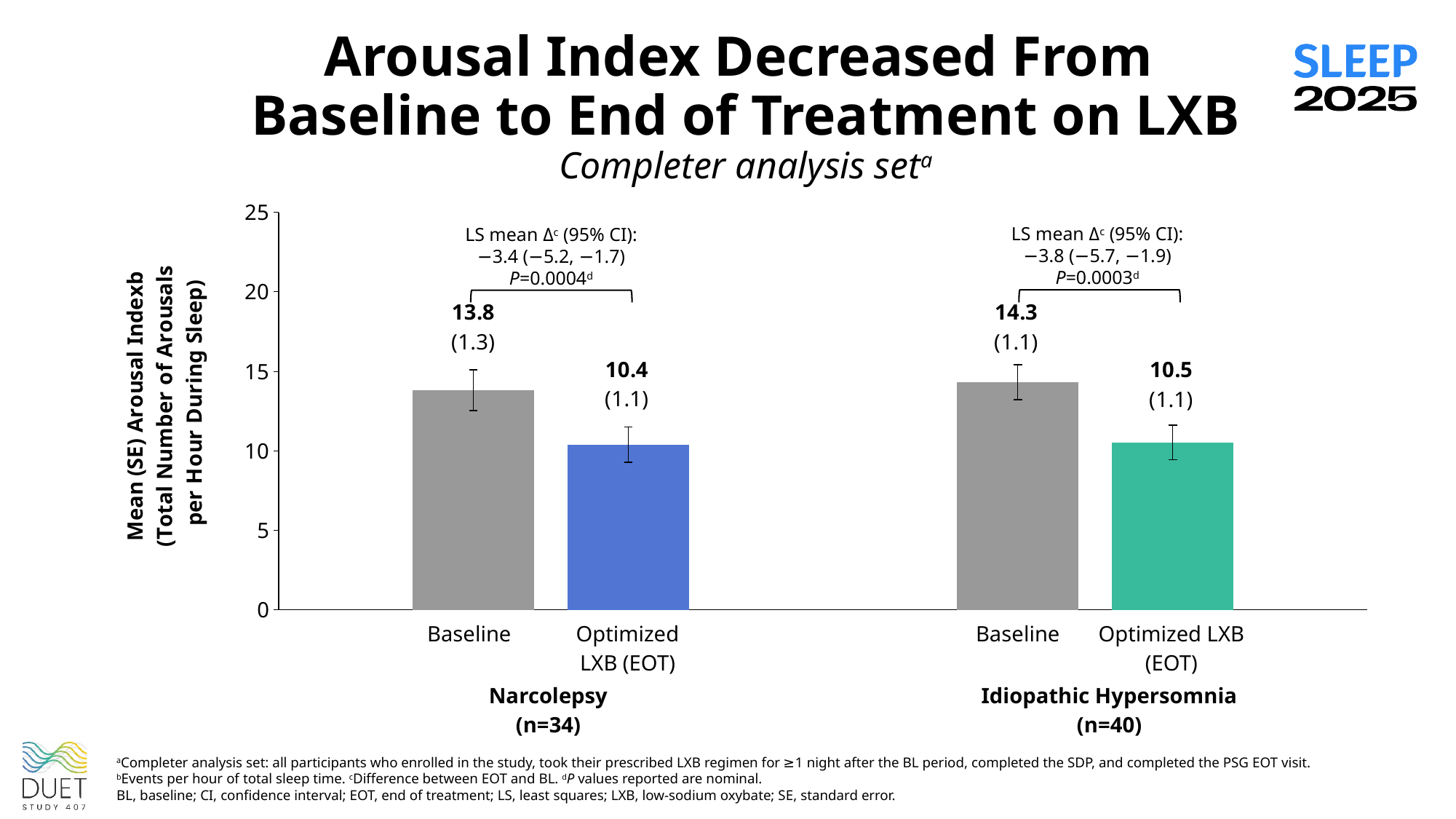
What is the mean arousal index at Baseline for the Narcolepsy group? 13.8 What is the LS mean change (95% CI) reported for the Idiopathic Hypersomnia group? −3.8 (−5.7, −1.9) How many bars are plotted on the chart? 4 What kind of chart is shown on the slide? Bar chart Is the Baseline mean arousal index for the Narcolepsy group greater or less than 15? less What is the difference between the Baseline and Optimized LXB (EOT) mean arousal index values in the Narcolepsy group? 3.4 What is the mean arousal index at Optimized LXB (EOT) for the Narcolepsy group? 10.4 Which is larger: the Baseline mean arousal index for Narcolepsy or for Idiopathic Hypersomnia? Idiopathic Hypersomnia What is the mean arousal index at Baseline for the Idiopathic Hypersomnia group? 14.3 What is the mean arousal index at Optimized LXB (EOT) for the Idiopathic Hypersomnia group? 10.5 Which bar has the lowest mean arousal index on the chart? Narcolepsy Optimized LXB (EOT) Which bar has the highest mean arousal index on the chart? Idiopathic Hypersomnia Baseline